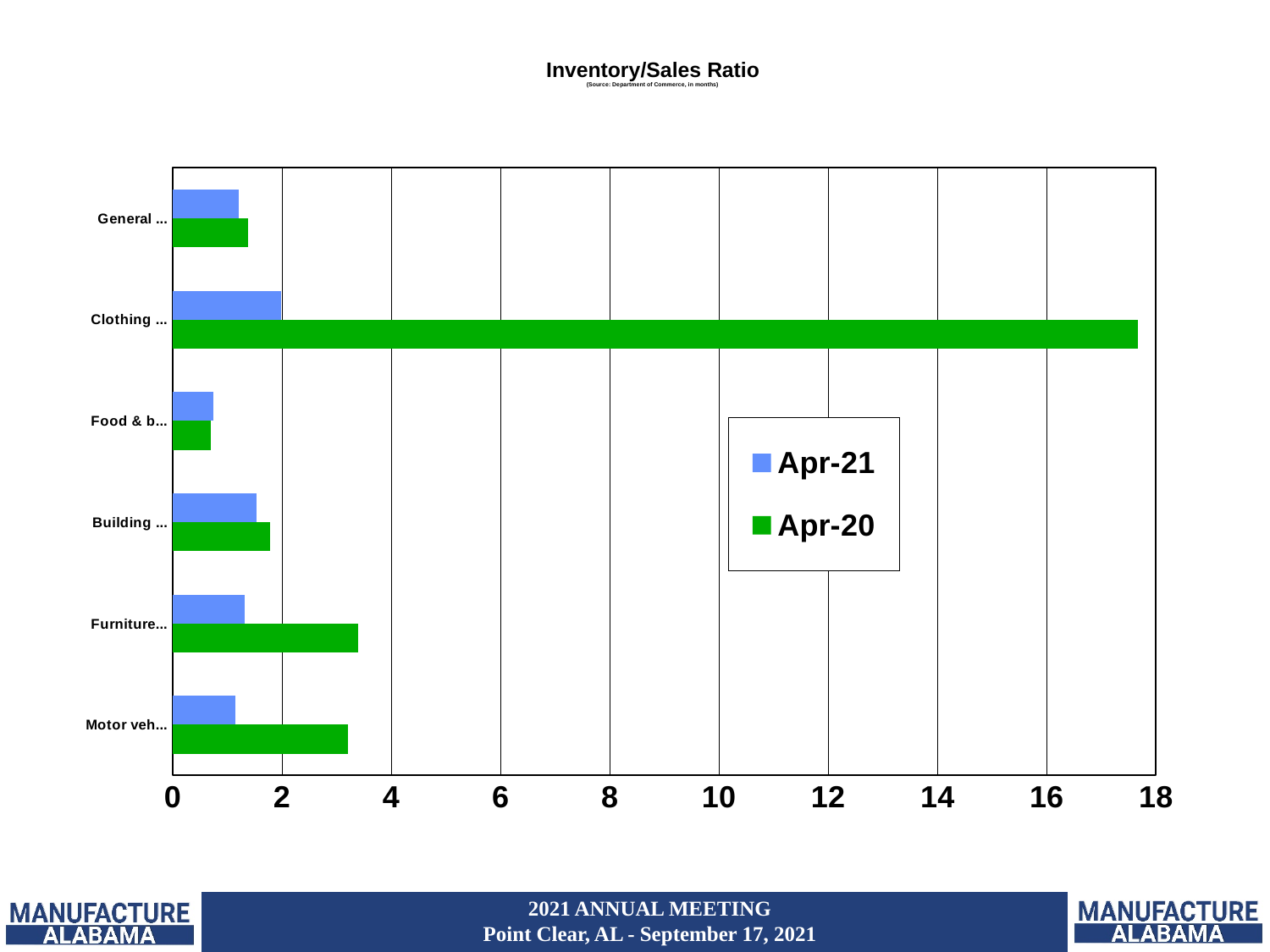
Which colour represents the Apr-20 series? green Which category has the highest Apr-20 value? Clothing Is the Apr-20 value for Motor veh... greater or less than 4? less Which category has the lowest Apr-20 value? Food & b... What is the title of the chart? Inventory/Sales Ratio For Clothing, which is larger: the Apr-21 value or the Apr-20 value? Apr-20 How many categories are plotted on the chart? 6 Is the Apr-20 value for Clothing greater or less than 16? greater Is the Apr-20 value for Furniture greater or less than 2? greater What kind of chart is shown on the slide? bar chart How many series does the legend list? 2 Which category has the highest Apr-21 value? Clothing